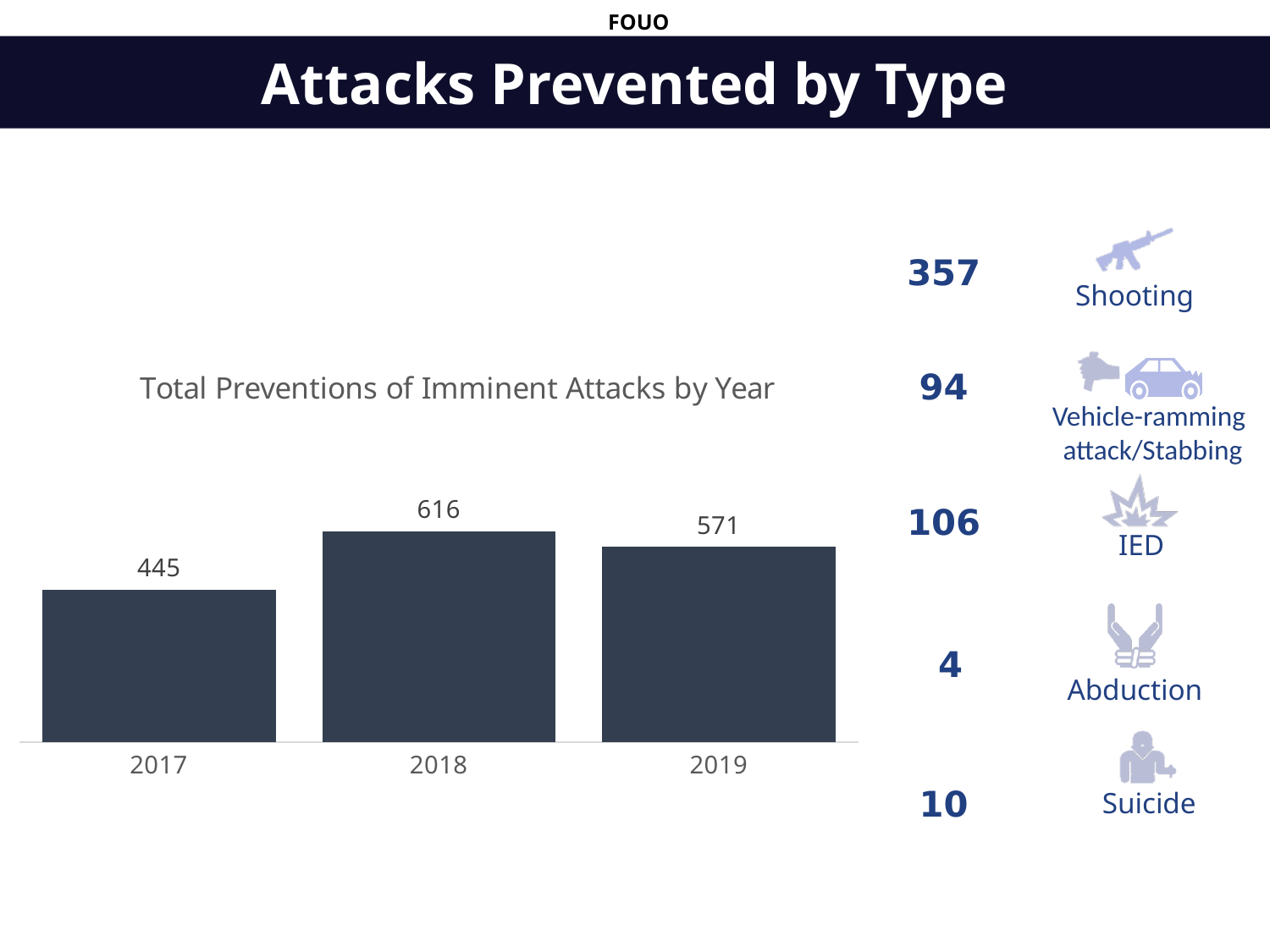
What is the value for 2019 in the chart 'Total Preventions of Imminent Attacks by Year'? 571 In the chart 'Total Preventions of Imminent Attacks by Year', which is larger, the value for 2019 or the value for 2017? 2019 In the chart 'Total Preventions of Imminent Attacks by Year', do the values rise or fall from 2018 to 2019? Fall What is the value for 2017 in the chart 'Total Preventions of Imminent Attacks by Year'? 445 What is the difference between the 2018 and 2019 values in the chart 'Total Preventions of Imminent Attacks by Year'? 45 How many years are shown in the chart 'Total Preventions of Imminent Attacks by Year'? 3 What is the difference between the 2018 and 2017 values in the chart 'Total Preventions of Imminent Attacks by Year'? 171 What kind of chart is 'Total Preventions of Imminent Attacks by Year'? Bar chart What is the title of the bar chart on the slide? Total Preventions of Imminent Attacks by Year What is the value for 2018 in the chart 'Total Preventions of Imminent Attacks by Year'? 616 Which year has the lowest value in the chart 'Total Preventions of Imminent Attacks by Year'? 2017 Which year has the highest value in the chart 'Total Preventions of Imminent Attacks by Year'? 2018